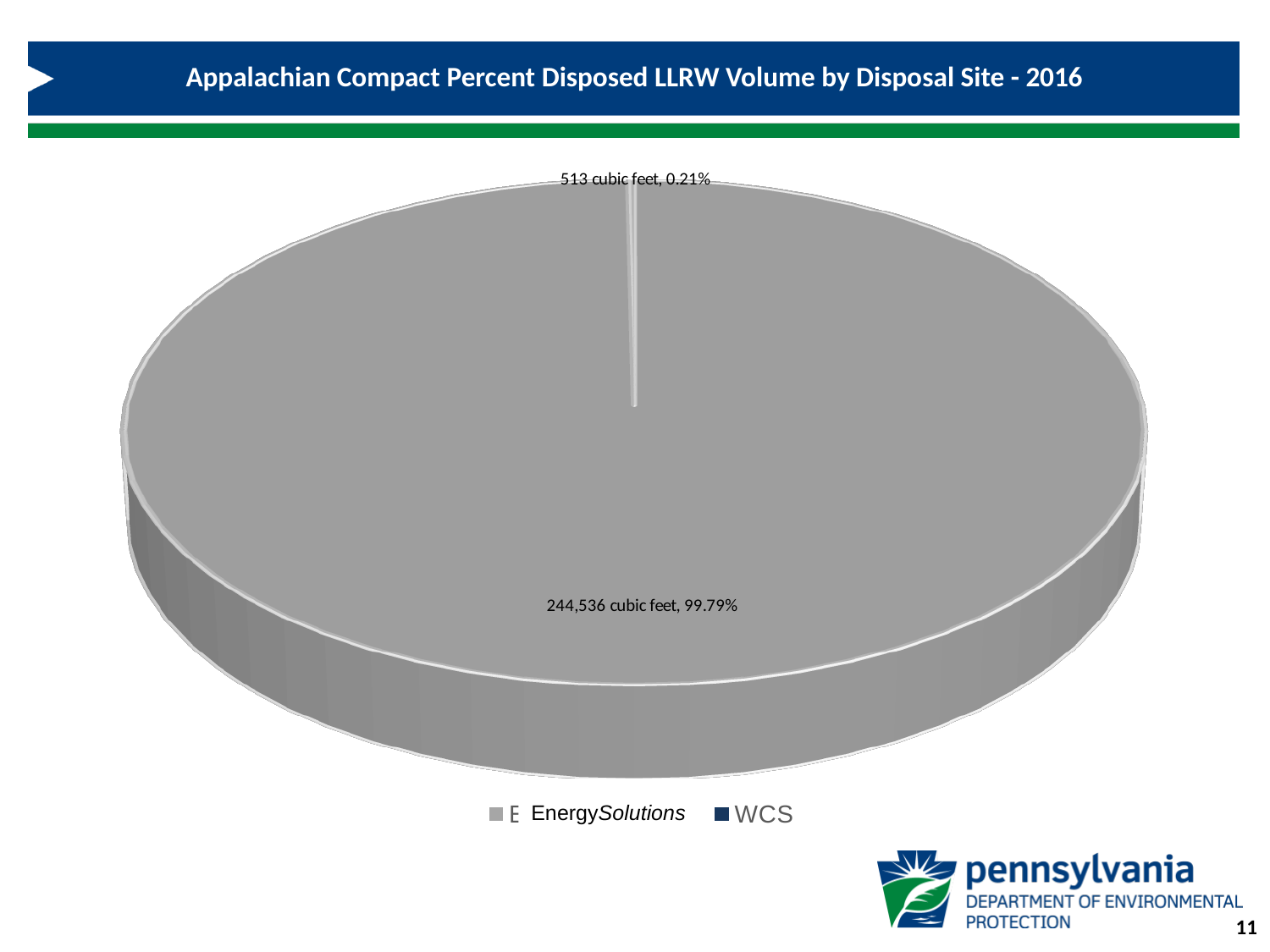
Which disposal site has the smallest slice of the pie? WCS What kind of chart is shown on the slide? Pie chart Which is larger, the volume for WCS or the volume for EnergySolutions? EnergySolutions What is the difference in volume between EnergySolutions and WCS? 244,023 cubic feet How many entries does the legend list? 2 Which disposal site has the largest slice of the pie? EnergySolutions How many slices does the pie chart have? 2 What percentage share of the pie does WCS have? 0.21% What is the title of the chart? Appalachian Compact Percent Disposed LLRW Volume by Disposal Site - 2016 What volume is shown for WCS? 513 cubic feet What volume is shown for EnergySolutions? 244,536 cubic feet What percentage share of the pie does EnergySolutions have? 99.79%